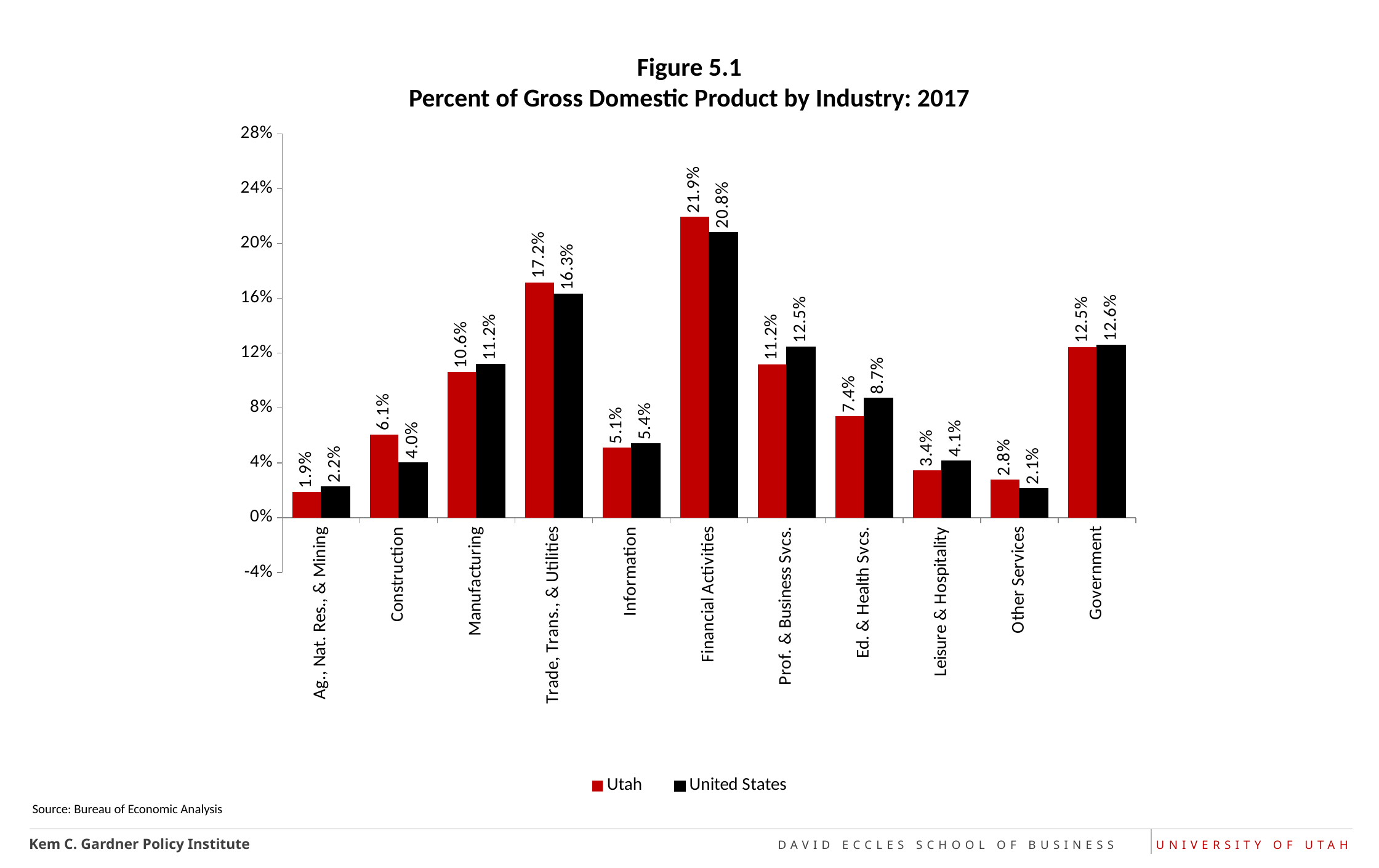
What is the Utah value for Construction? 6.1% What is the United States value for Ed. & Health Svcs.? 8.7% Which industry has the lowest Utah value? Ag., Nat. Res., & Mining What is the difference between the Utah and United States values for Trade, Trans., & Utilities? 0.9% What is the Utah value for Financial Activities? 21.9% How many industries are shown on the x axis? 11 Is the Utah value for Government greater or less than 8%? greater What colour represents Utah in the chart? Red Which industry has the highest United States value? Financial Activities What kind of chart is shown? Bar chart Which is larger for Manufacturing, the Utah value or the United States value? United States How many series does the legend list? 2